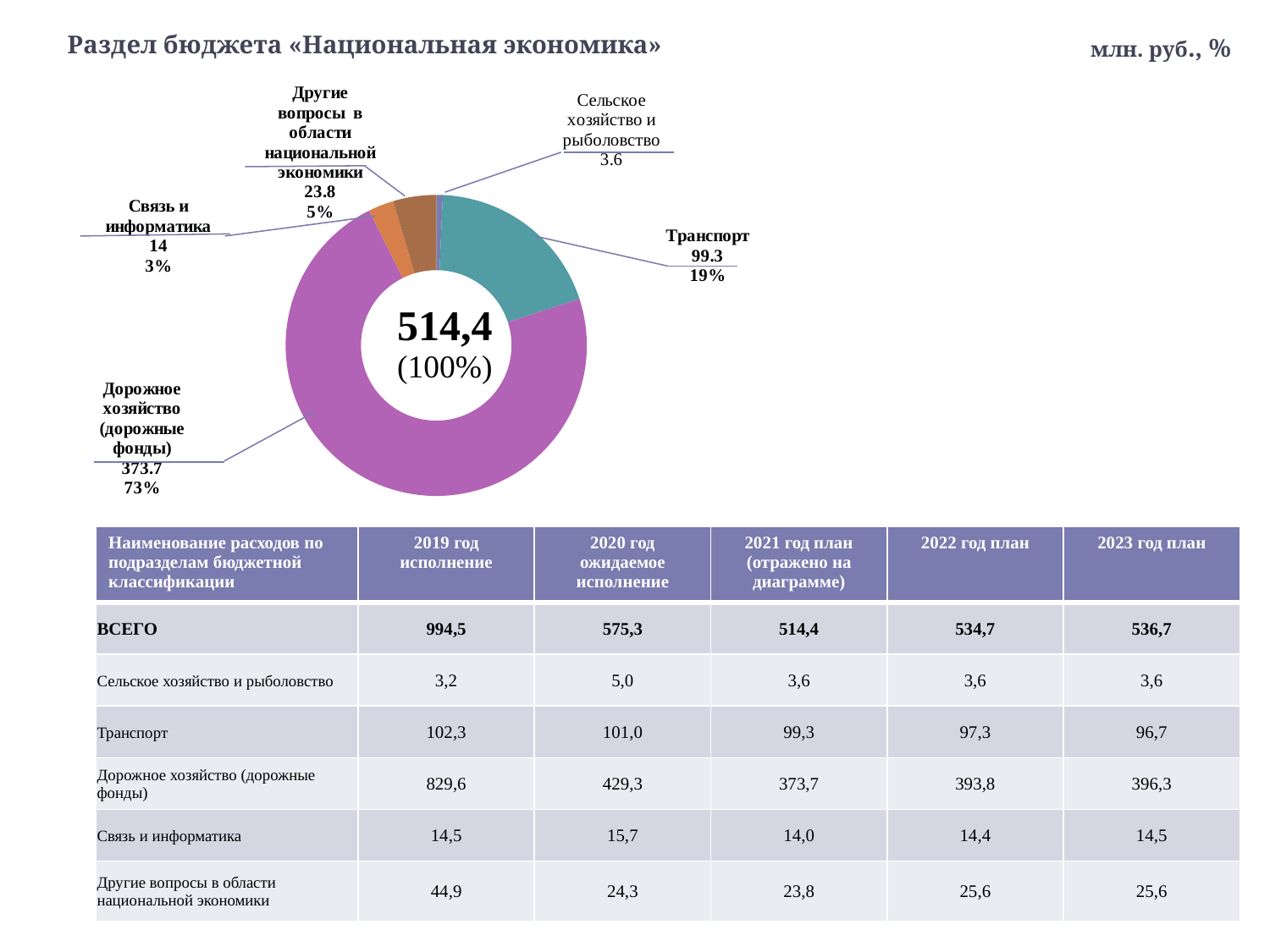
What total value is shown in the centre of the chart? 514,4 What value is shown for Дорожное хозяйство (дорожные фонды) on the chart? 373.7 Which category has the largest slice on the chart? Дорожное хозяйство (дорожные фонды) What kind of chart is shown on the slide? Doughnut (pie) chart What value is shown for Транспорт on the chart? 99.3 What value is shown for Сельское хозяйство и рыболовство on the chart? 3.6 What percentage share does Транспорт have on the chart? 19% What percentage share does Дорожное хозяйство (дорожные фонды) have on the chart? 73% Which category has the smallest slice on the chart? Сельское хозяйство и рыболовство What is the difference between the values for Транспорт and Связь и информатика on the chart? 85.3 What value is shown for Связь и информатика on the chart? 14 How many categories are shown on the chart? 5